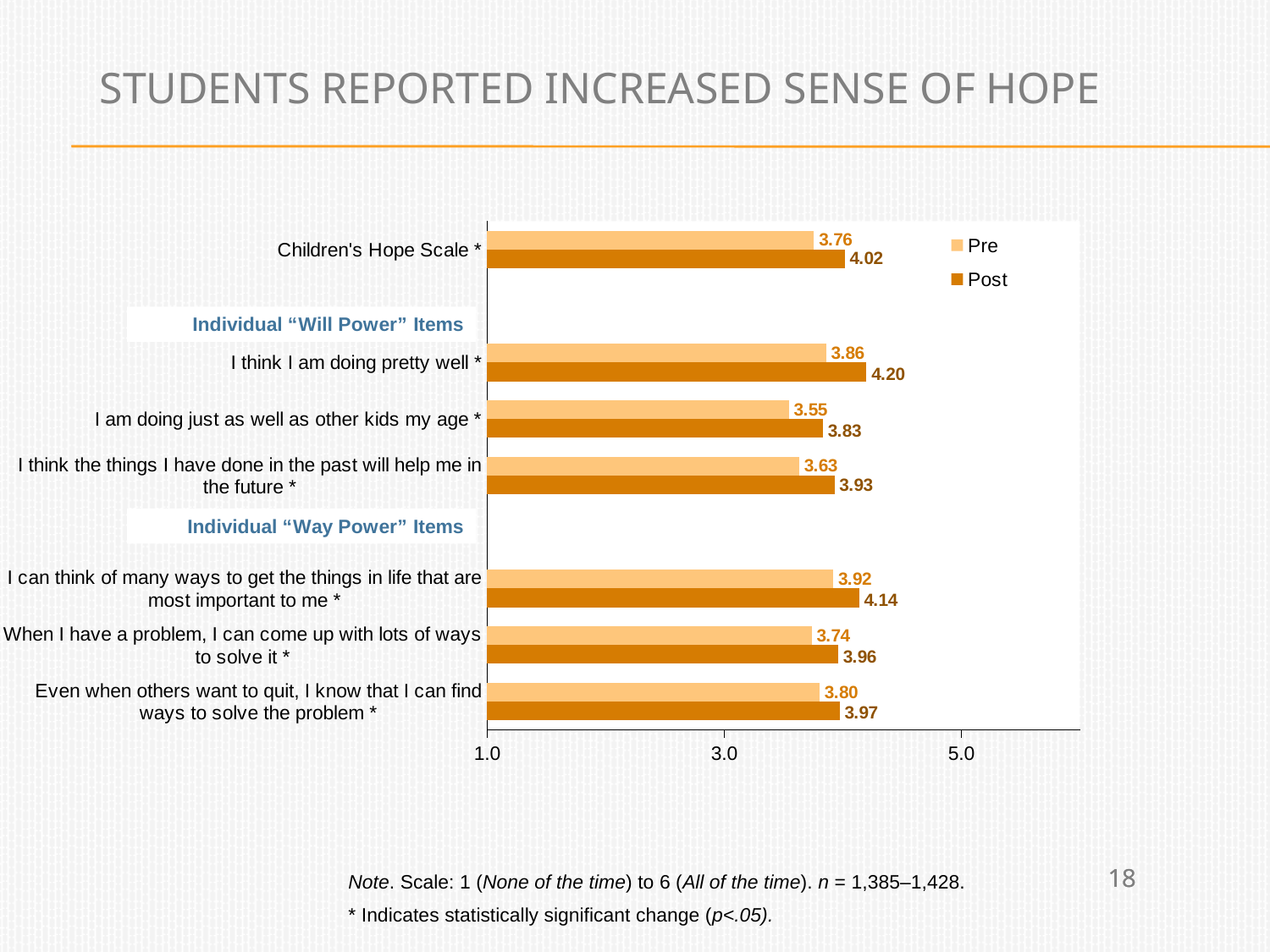
What is the Post value for "Children's Hope Scale"? 4.02 Which item has the highest Post value? I think I am doing pretty well Which is larger: the Pre value for "I can think of many ways to get the things in life that are most important to me" or the Pre value for "Even when others want to quit, I know that I can find ways to solve the problem"? I can think of many ways to get the things in life that are most important to me What is the Pre value for "I am doing just as well as other kids my age"? 3.55 What is the difference between the Post and Pre values for "Children's Hope Scale"? 0.26 What is the Post value for "I think I am doing pretty well"? 4.20 Which item has the lowest Pre value? I am doing just as well as other kids my age What is the difference between the Post and Pre values for "I think I am doing pretty well"? 0.34 Is the Post value for "I am doing just as well as other kids my age" greater or less than 3.0? greater What is the title of the slide containing the chart? STUDENTS REPORTED INCREASED SENSE OF HOPE What kind of chart is shown on the slide? Bar chart How many series does the legend list? 2